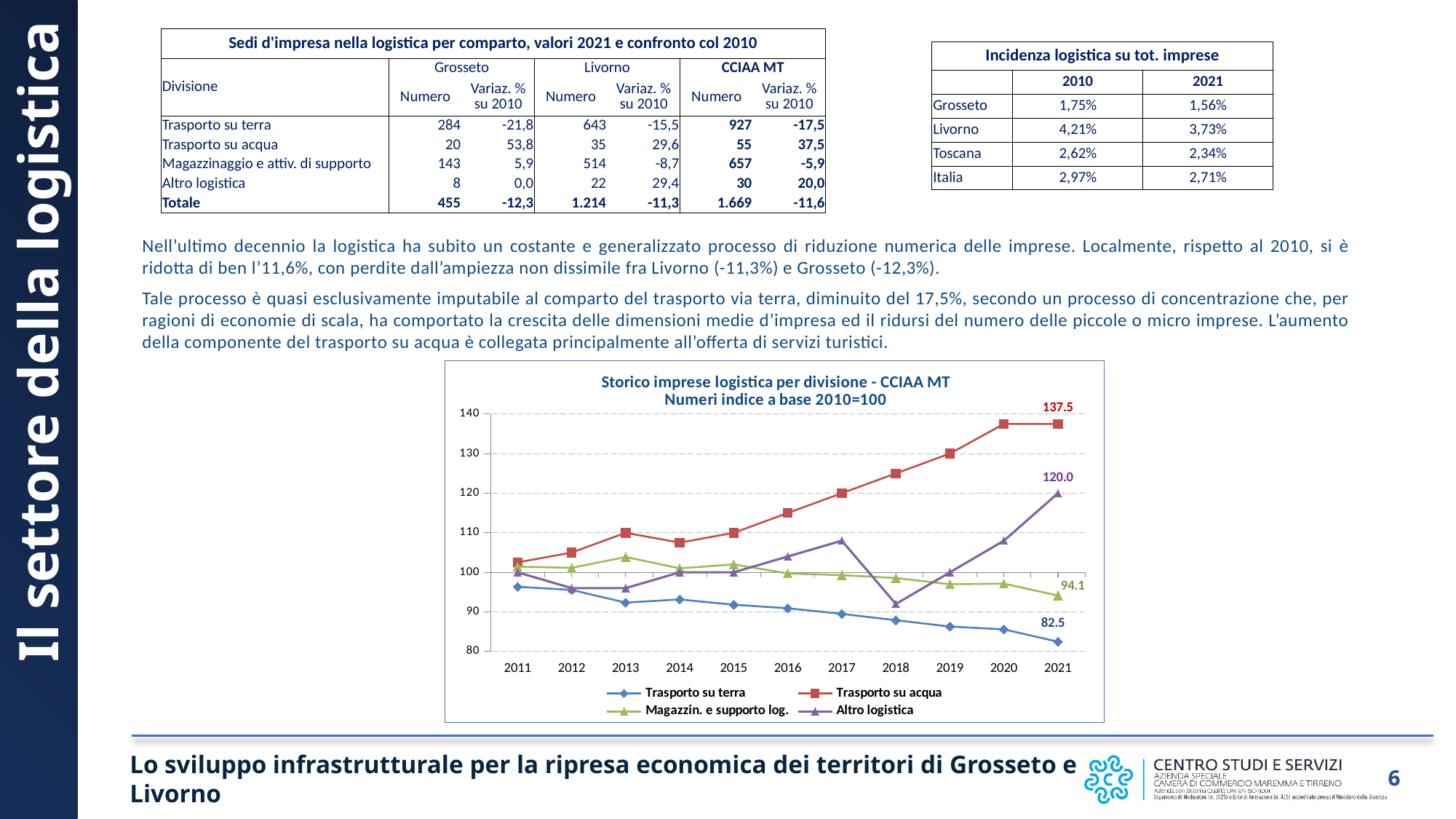
What kind of chart is shown on the slide? line chart What is the difference between the 2021 values of Trasporto su acqua and Trasporto su terra? 55.0 Which series has the lowest index value in 2021? Trasporto su terra Does the Trasporto su terra series rise or fall from 2011 to 2021? fall What is the 2021 index value for Magazzin. e supporto log.? 94.1 How many series does the chart legend list? 4 Is the value for Trasporto su terra in 2016 greater or less than 100? less How many years are plotted along the x axis of the chart? 11 What is the 2021 index value for Trasporto su acqua? 137.5 What is the 2021 index value for Trasporto su terra? 82.5 What is the 2021 index value for Altro logistica? 120.0 Which series has the highest index value in 2021? Trasporto su acqua